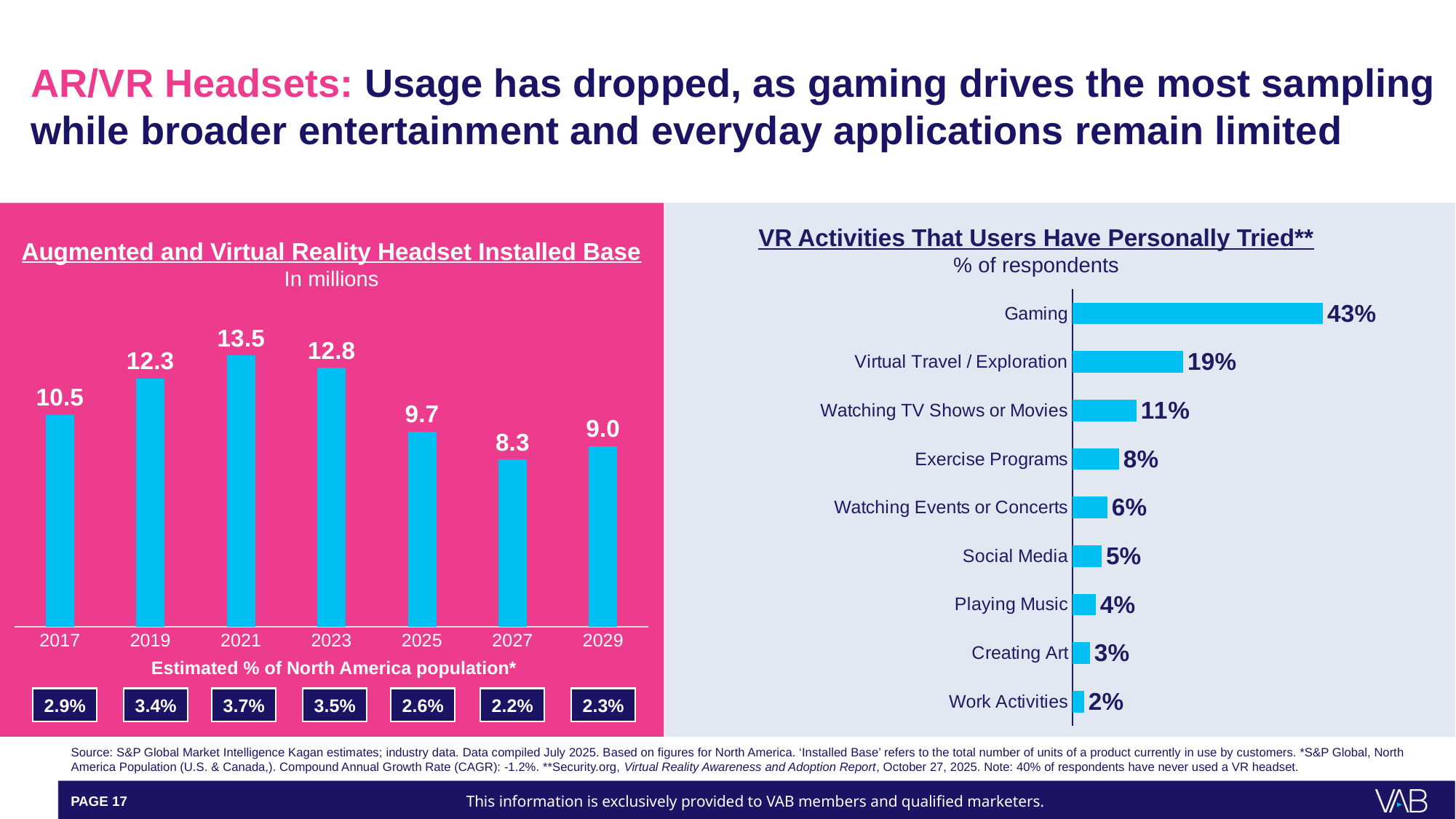
What kind of chart is the 'VR Activities That Users Have Personally Tried' chart? Bar chart In the 'Augmented and Virtual Reality Headset Installed Base' chart, how many years are plotted? 7 In the 'Augmented and Virtual Reality Headset Installed Base' chart, what is the estimated % of North America population shown for 2023? 3.5% In the 'Augmented and Virtual Reality Headset Installed Base' chart, which year has the highest installed base? 2021 In the 'VR Activities That Users Have Personally Tried' chart, which activity has the lowest share of respondents? Work Activities In the 'VR Activities That Users Have Personally Tried' chart, what is the difference between Gaming and Watching TV Shows or Movies? 32% In the 'Augmented and Virtual Reality Headset Installed Base' chart, is the value for 2025 larger or smaller than the value for 2029? larger In the 'Augmented and Virtual Reality Headset Installed Base' chart, what is the value for 2021? 13.5 In the 'Augmented and Virtual Reality Headset Installed Base' chart, which year has the lowest installed base? 2027 In the 'Augmented and Virtual Reality Headset Installed Base' chart, what is the difference between the 2021 and 2027 values? 5.2 In the 'VR Activities That Users Have Personally Tried' chart, what percentage of respondents have tried Virtual Travel / Exploration? 19% In the 'VR Activities That Users Have Personally Tried' chart, which activity has the highest share of respondents? Gaming